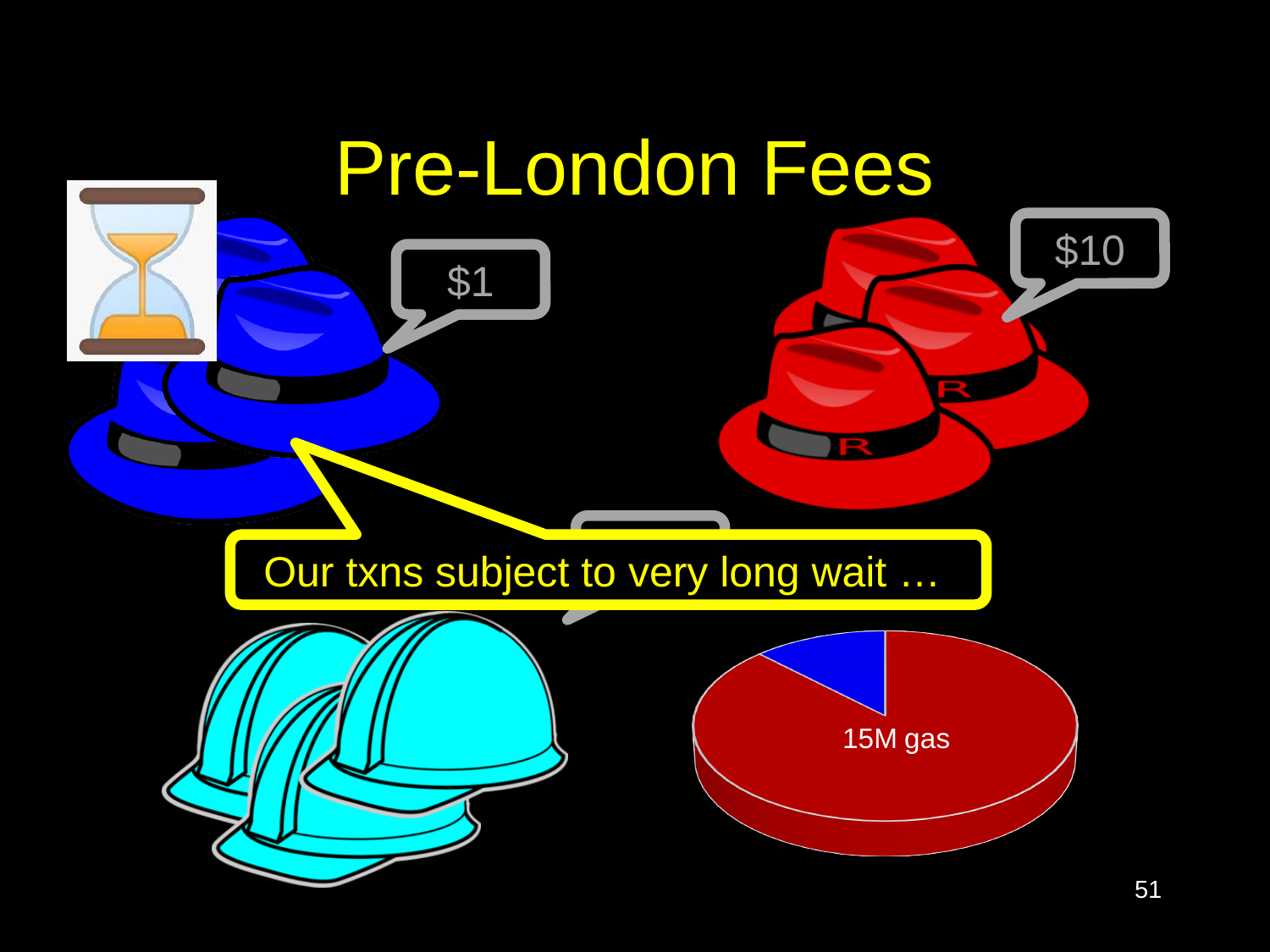
Which slice of the pie chart is larger, the red one or the blue one? red What data label is printed on the red slice of the pie chart? 15M gas What colours are the two slices of the pie chart? red and blue What kind of chart is shown at the bottom right of the slide? pie chart Which colour slice takes up the smallest share of the pie chart? blue Is the blue slice of the pie chart greater or less than a quarter of the pie? less Is the red slice of the pie chart greater or less than half of the pie? greater How many slices does the pie chart have? 2